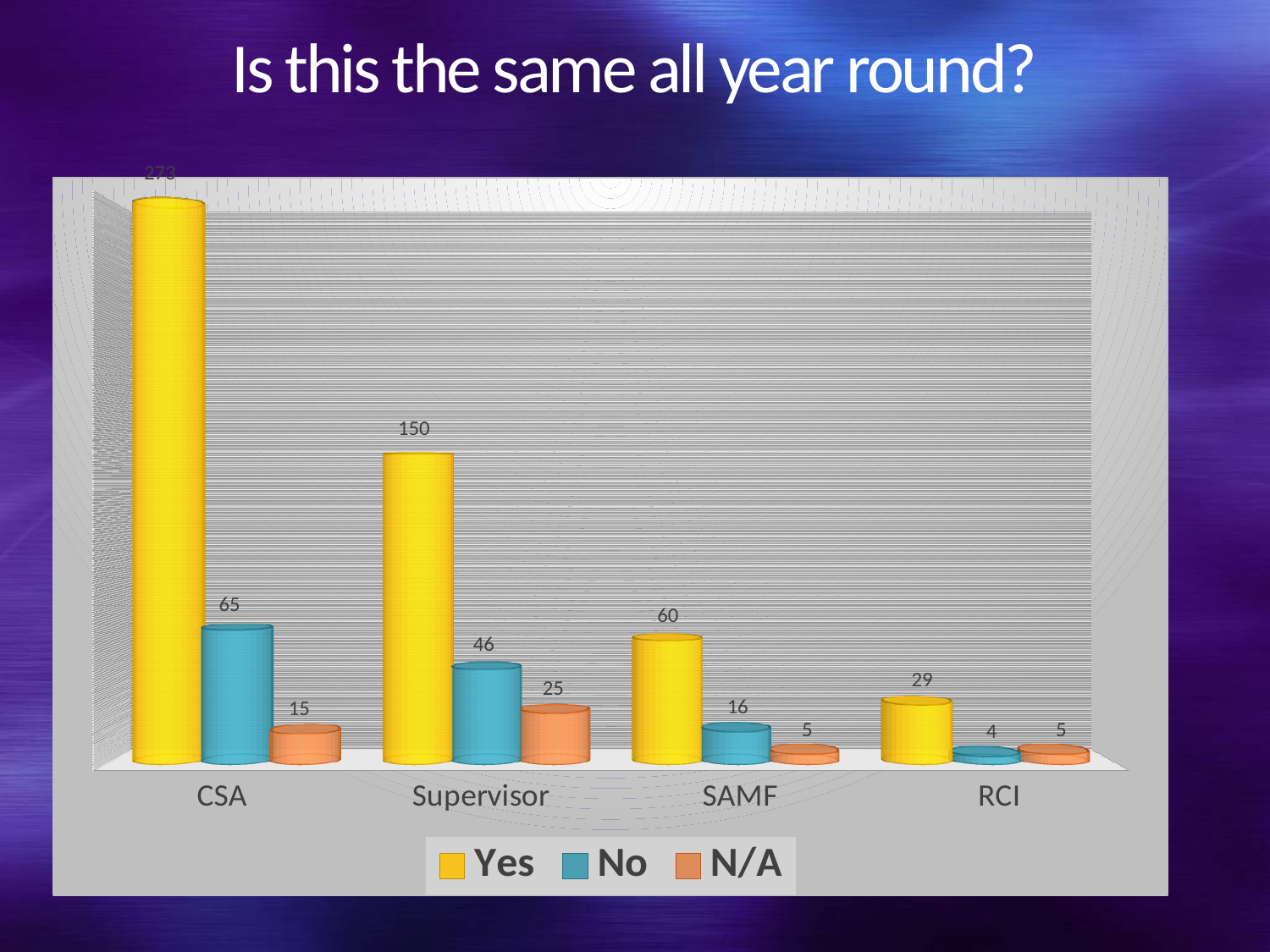
How many categories are shown on the x axis? 4 Which is larger, the No value for Supervisor or the Yes value for RCI? No value for Supervisor Which category has the highest Yes value? CSA What is the No value for CSA? 65 What type of chart is shown on the slide? bar chart What is the Yes value for Supervisor? 150 Which category has the lowest No value? RCI What is the Yes value for RCI? 29 How many series does the legend list? 3 What is the N/A value for Supervisor? 25 What is the difference between the Yes and No values for SAMF? 44 What is the title of the chart? Is this the same all year round?